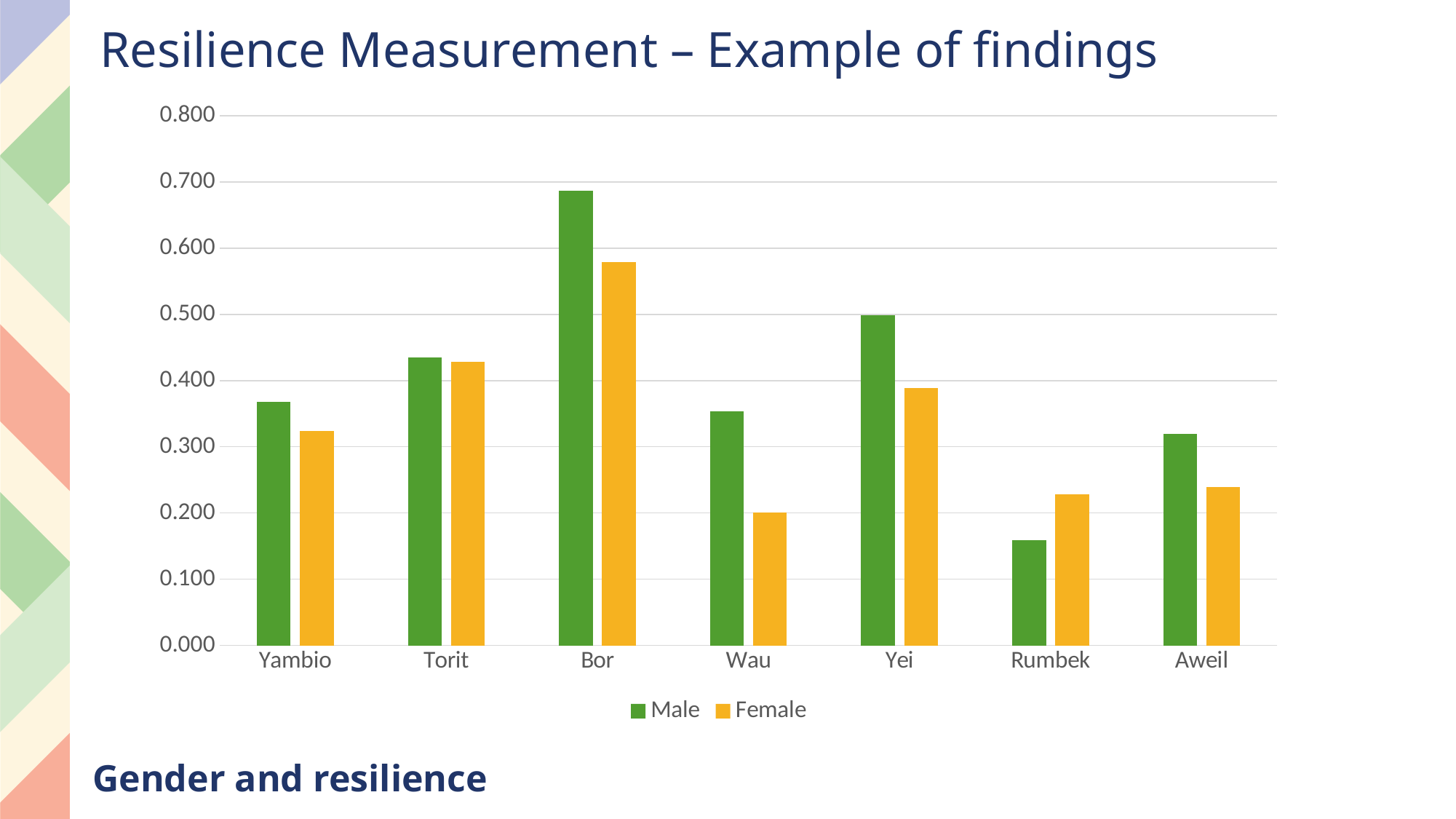
What kind of chart is shown on the slide? bar chart Is the Female value for Bor greater or less than 0.600? less Which location has the highest Male value? Bor In Wau, which is larger, the Male value or the Female value? Male Which location has the highest Female value? Bor In Rumbek, which is larger, the Male value or the Female value? Female Is the Male value for Rumbek greater or less than 0.200? less What colour are the Female bars? orange How many locations are shown on the x axis? 7 How many series does the legend list? 2 Which location has the lowest Male value? Rumbek Is the Male value for Bor greater or less than 0.600? greater